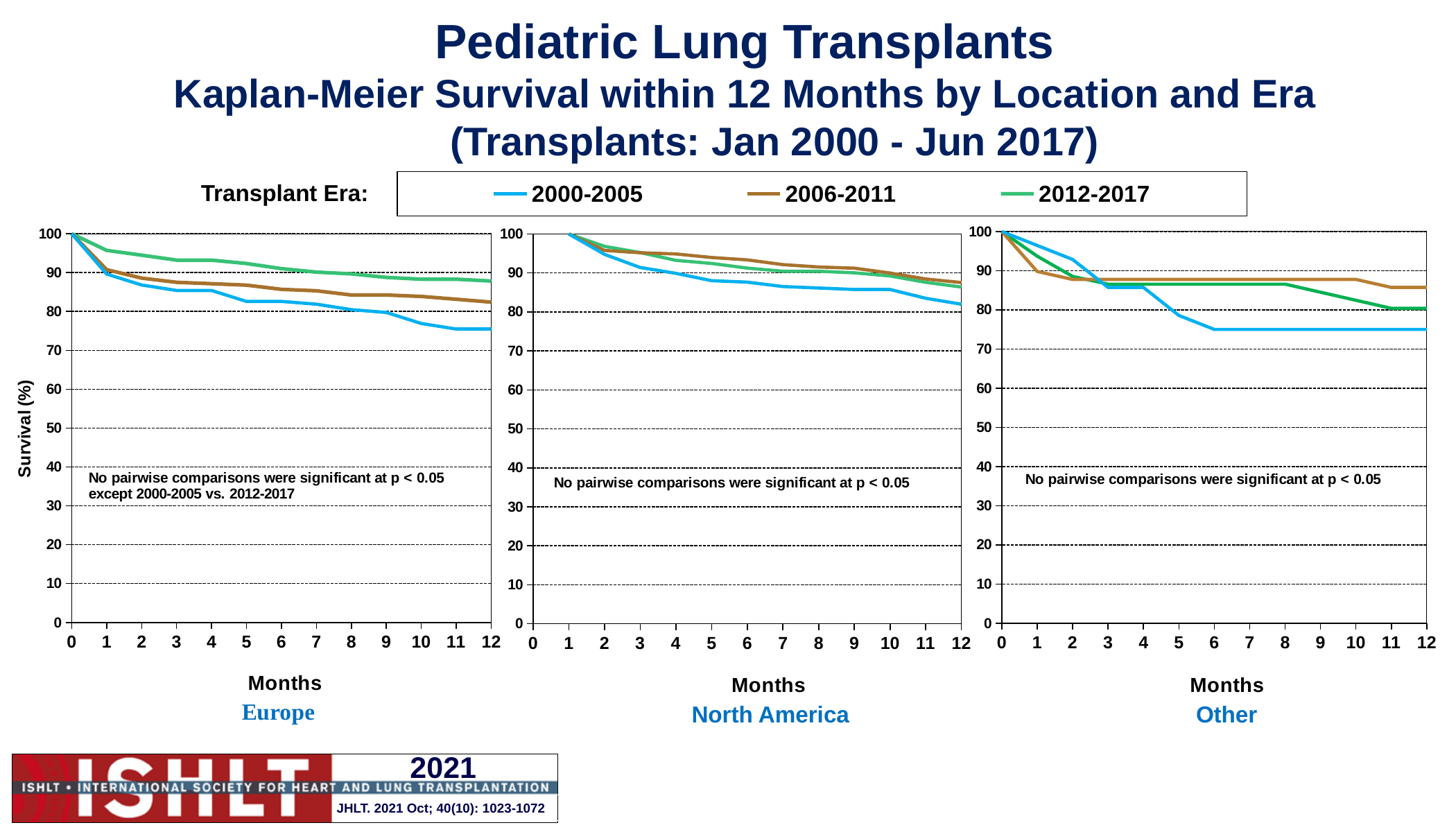
In the Other chart, which transplant era has the highest survival at 12 months? 2006-2011 In the Europe chart, is the 12-month survival for the 2012-2017 era greater or less than 80? greater What kind of chart is used for the Europe panel? line chart In the Other chart, is the 12-month survival for the 2000-2005 era greater or less than 80? less In the North America chart, does survival for the 2000-2005 era rise or fall as months increase? fall What is the label on the vertical axis of the charts? Survival (%) In the Other chart, at 12 months, which era has higher survival: 2006-2011 or 2000-2005? 2006-2011 How many transplant eras does the legend list? 3 In the Europe chart, is the 12-month survival for the 2000-2005 era greater or less than 80? less In the Europe chart, which transplant era has the highest survival at 12 months? 2012-2017 In the North America chart, which transplant era has the lowest survival at 12 months? 2000-2005